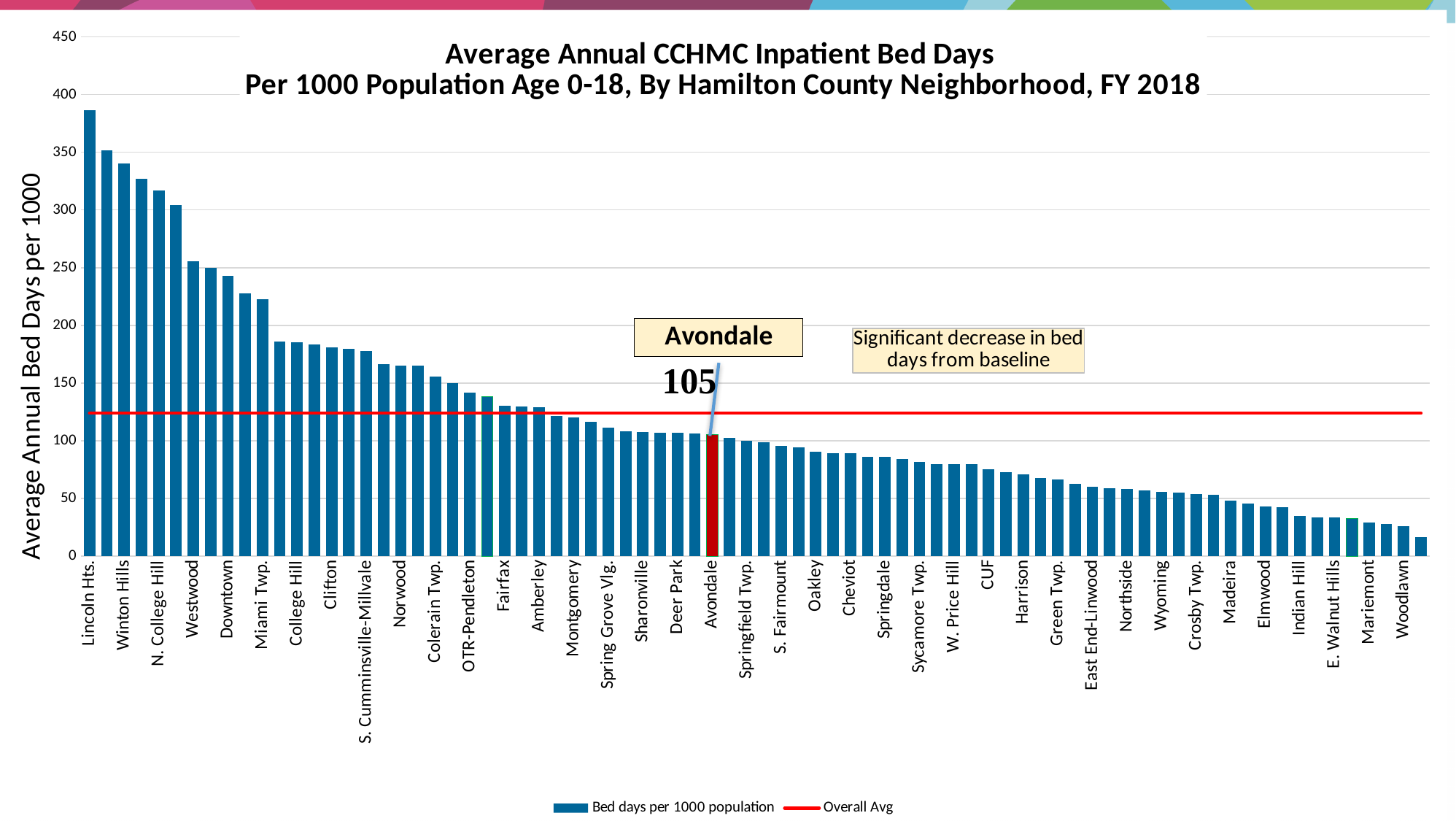
Is the value for Downtown greater or less than 200? greater What type of chart is shown on the slide? Combination bar and line chart (bars with a horizontal average line) What is the value of average annual bed days per 1000 for Avondale? 105 Is the value for Woodlawn greater or less than 50? less Do the bar values rise or fall moving from left to right along the x axis? fall Which has a higher value, Clifton or Oakley? Clifton Is the value for Montgomery greater or less than 150? less How many series does the legend list? 2 Which neighborhood has the highest average annual bed days per 1000? Lincoln Hts. What does the red horizontal line represent according to the legend? Overall Avg